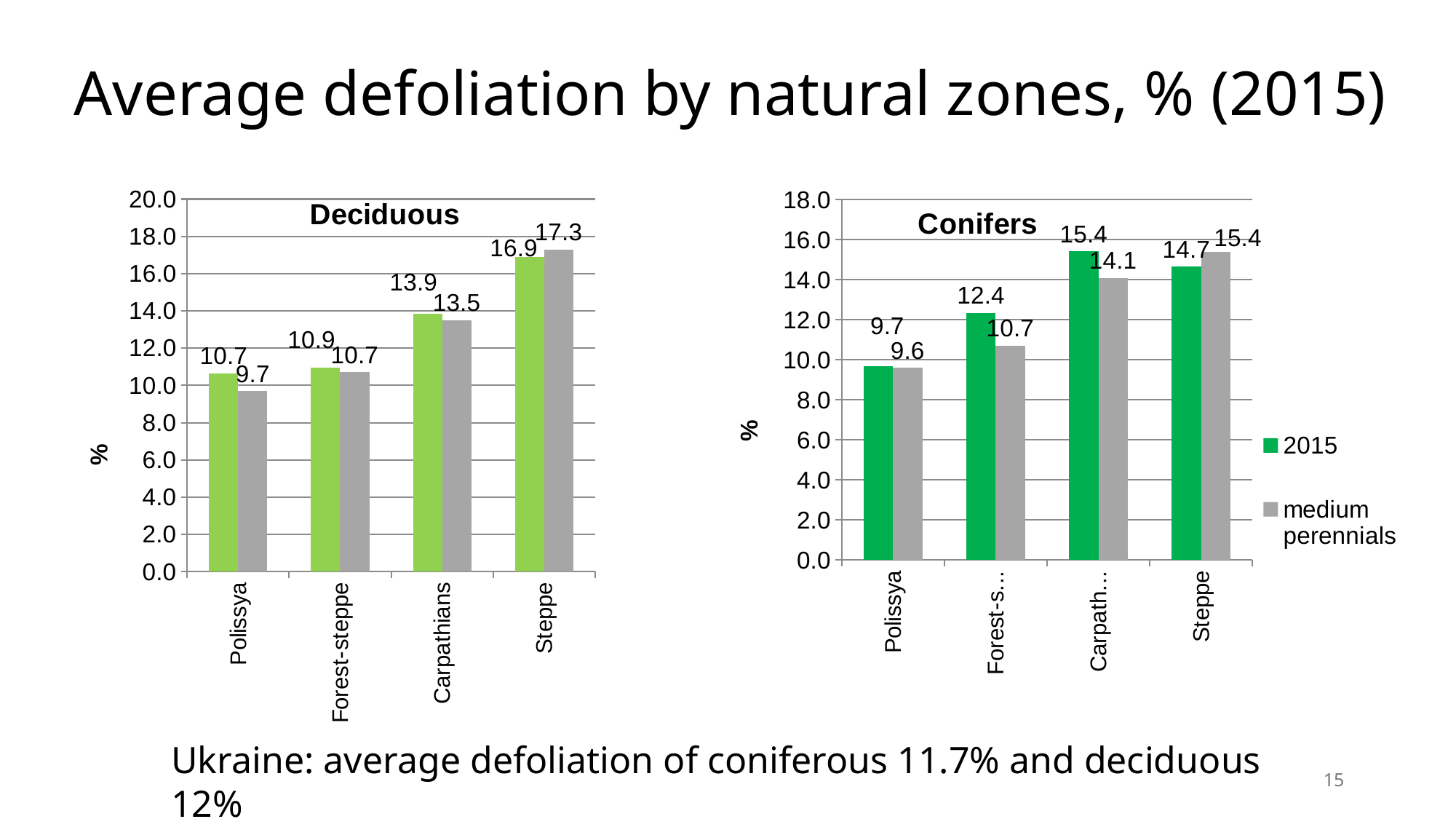
What type of chart is the Conifers chart? bar chart In the Deciduous chart, which natural zone has the lowest grey bar? Polissya In the Deciduous chart, what is the value of the green bar for Steppe? 16.9 In the Deciduous chart, which natural zone has the highest green bar? Steppe In the Conifers chart, what is the difference between the 2015 and medium perennials values for Steppe? 0.7 How many series does the legend of the Conifers chart list? 2 In the Deciduous chart, what is the difference between the grey and green bars for Steppe? 0.4 In the Conifers chart, which is larger for Steppe: the 2015 value or the medium perennials value? medium perennials In the Conifers chart, what is the medium perennials value for Steppe? 15.4 How many natural zones are shown on the x axis of the Deciduous chart? 4 In the Deciduous chart, what is the value of the grey bar for Carpathians? 13.5 In the Conifers chart, what is the 2015 value for Polissya? 9.7